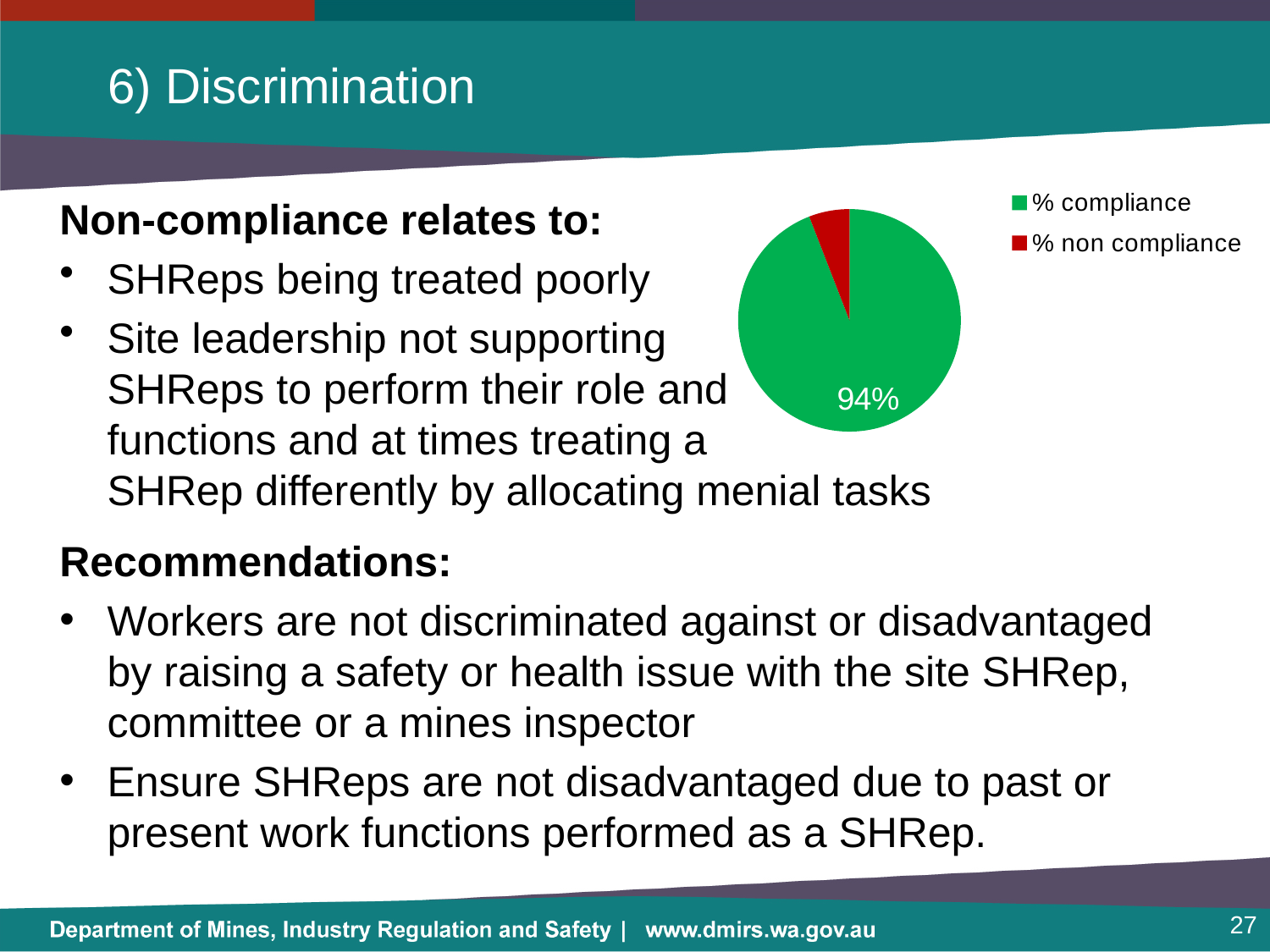
What percentage is shown for % compliance in the pie chart? 94% Which slice of the pie chart is the largest? % compliance What share of the pie does the % compliance slice represent? 94% What kind of chart is shown on the slide? pie chart How many slices does the pie chart have? 2 What colour is the % compliance slice in the pie chart? green Which slice of the pie chart is the smallest? % non compliance Which is larger in the pie chart, % compliance or % non compliance? % compliance How many entries does the legend of the pie chart list? 2 What colour is the % non compliance slice in the pie chart? red